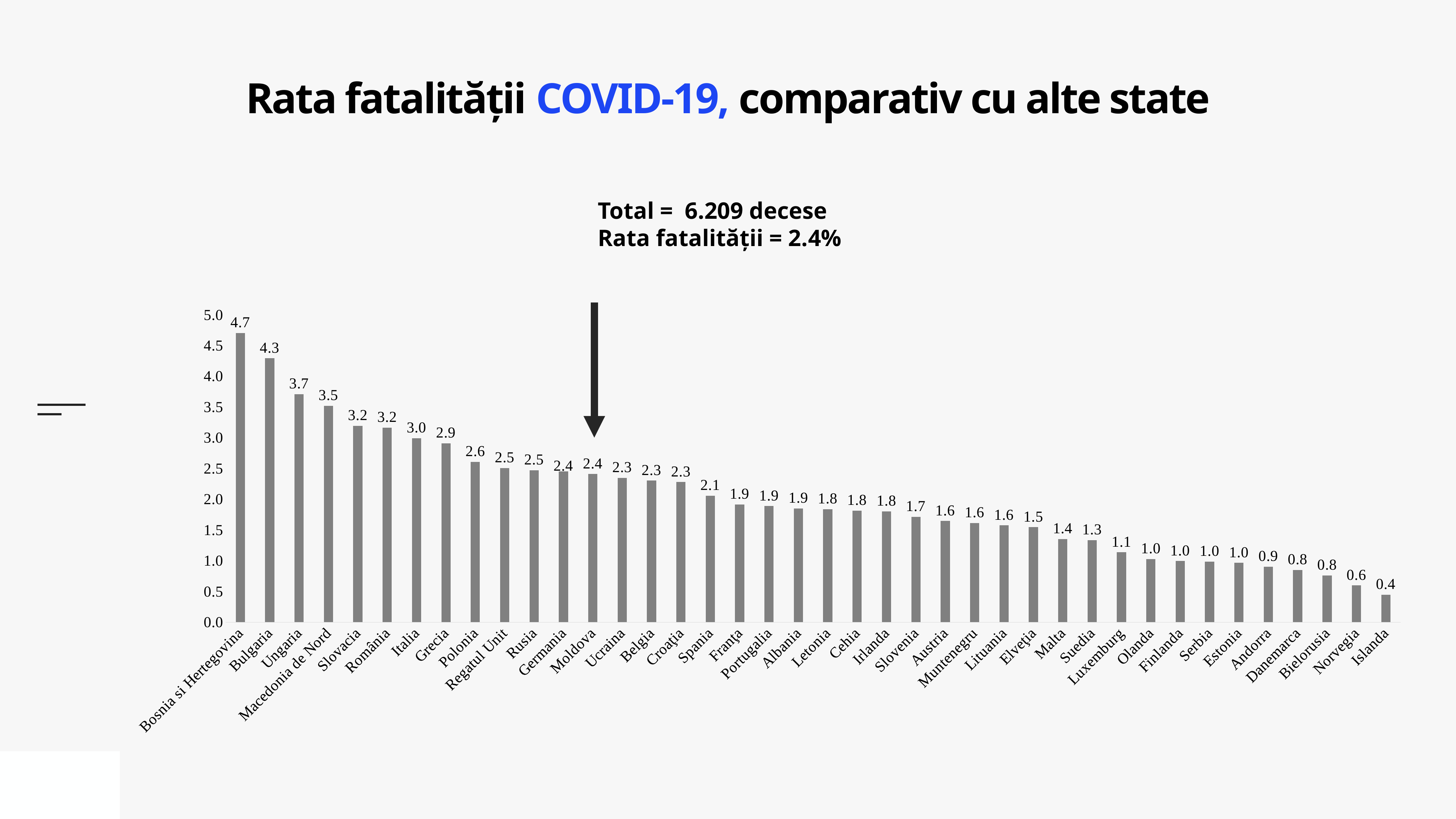
Which country has the highest value? Bosnia si Hertegovina How many countries are shown on the chart? 40 What kind of chart is shown on the slide? Bar chart Which has a larger value, Polonia or Spania? Polonia What is the value for Bulgaria? 4.3 Do the values rise or fall from left to right along the x axis? Fall What is the value for Moldova? 2.4 What is the value for Italia? 3.0 Which country has the lowest value? Islanda What is the difference between the values for Ungaria and Moldova? 1.3 What is the value for Norvegia? 0.6 What is the difference between the values for Bosnia si Hertegovina and Islanda? 4.3